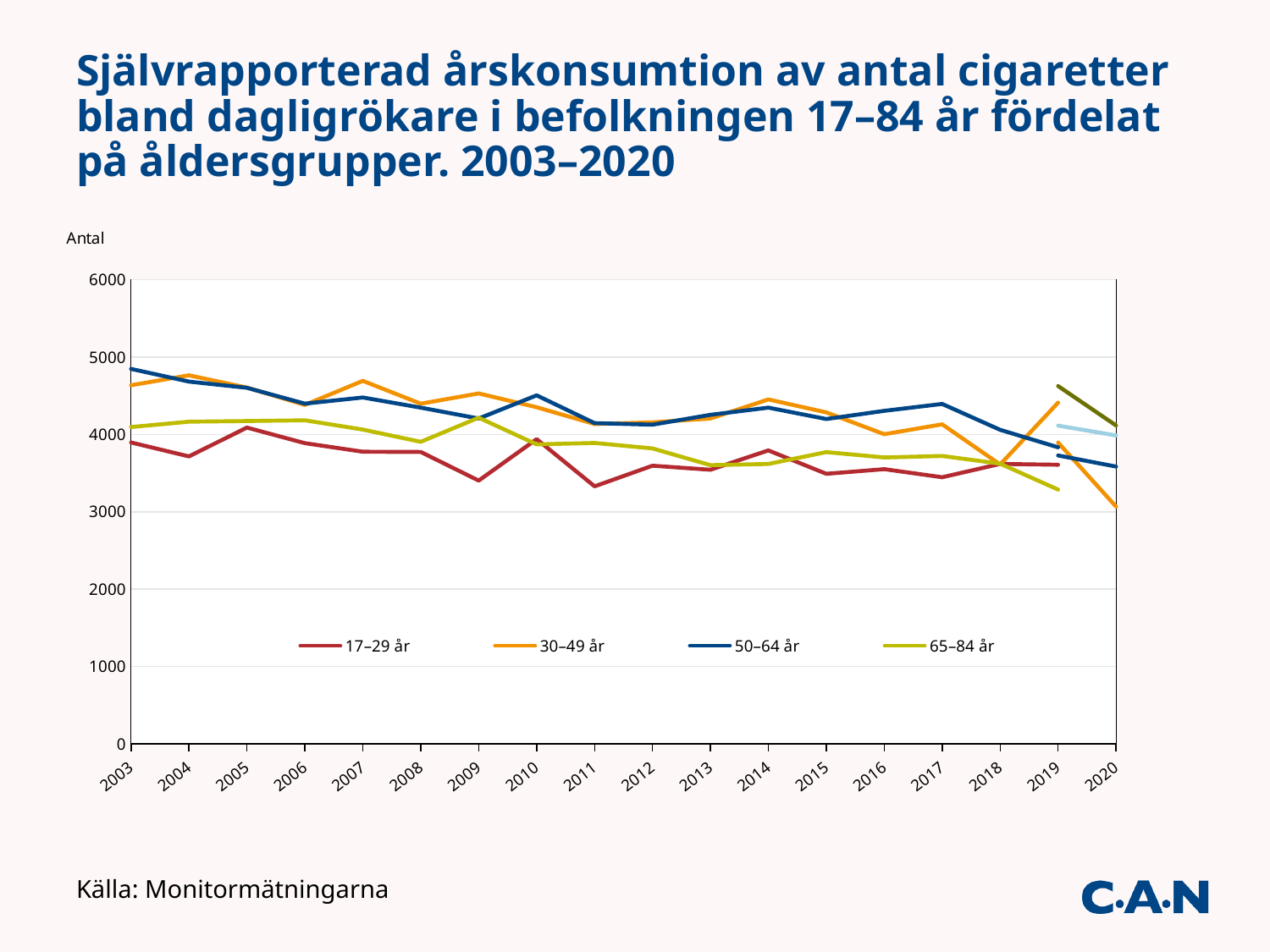
Is the value for 17–29 år in 2011 greater or less than 4000? less What is the label on the y axis? Antal Which age group has the highest value in 2003? 50–64 år Is the value for 65–84 år in 2019 greater or less than 3500? less How many series does the legend list? 4 How many years are shown along the x axis? 18 Does the value for 50–64 år rise or fall from 2003 to 2020? fall What kind of chart is shown on the slide? line chart In 2003, which is larger: the value for 50–64 år or the value for 17–29 år? 50–64 år Which age group has the lowest value in 2003? 17–29 år Is the value for 50–64 år in 2003 greater or less than 4000? greater